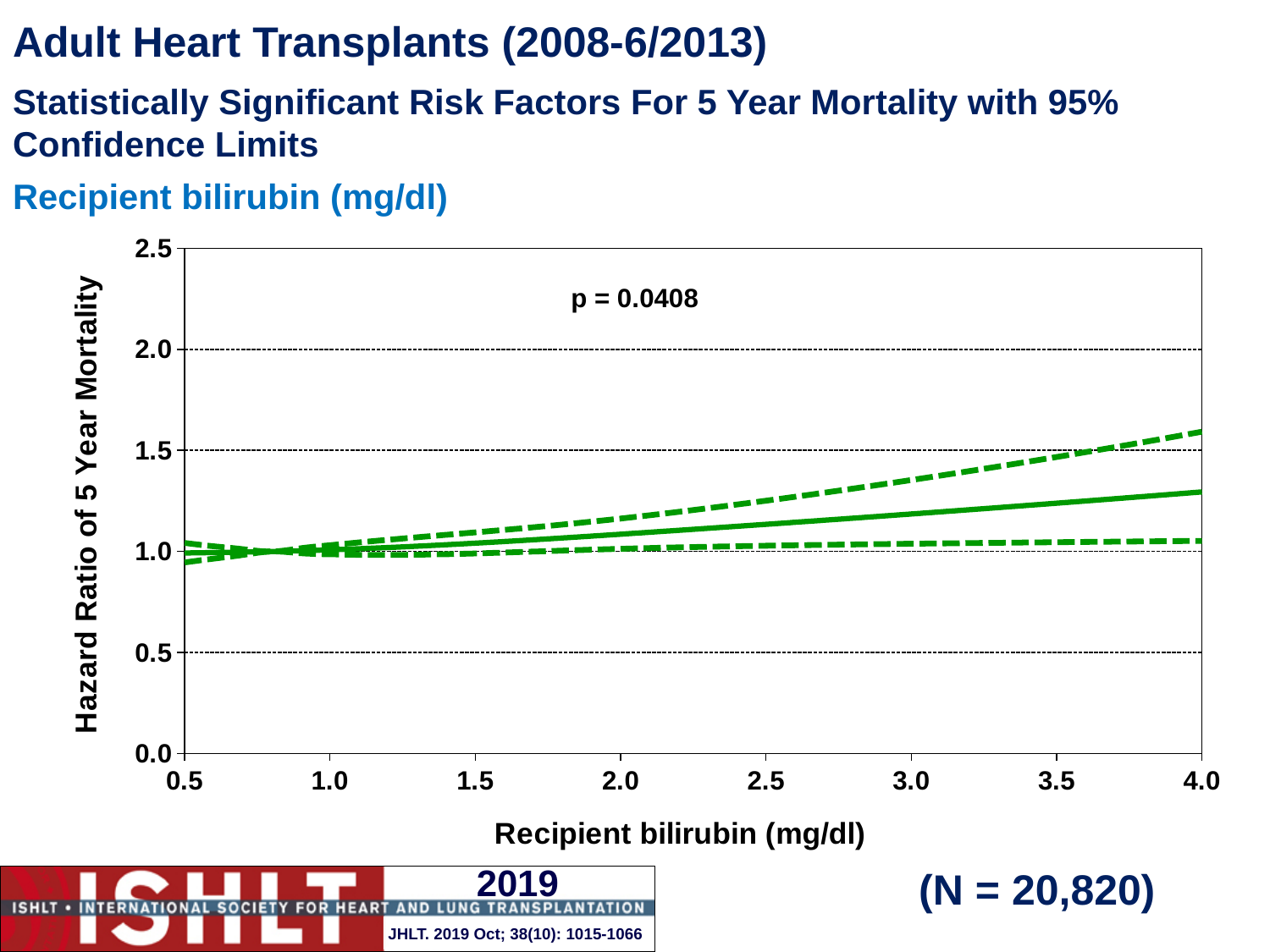
Is the upper dashed confidence limit at a recipient bilirubin of 2.0 mg/dl greater or less than 1.5? less Does the hazard ratio of 5 year mortality rise or fall as recipient bilirubin increases from 0.5 to 4.0 mg/dl? rise Is the lower dashed confidence limit at a recipient bilirubin of 4.0 mg/dl greater or less than 1.5? less What p-value is printed on the chart? p = 0.0408 Is the hazard ratio on the solid line at a recipient bilirubin of 4.0 mg/dl greater or less than 1.0? greater How many lines are plotted on the chart? 3 At a recipient bilirubin of 4.0 mg/dl, which is larger: the upper dashed line or the lower dashed line? the upper dashed line What is the N shown on the slide? N = 20,820 How many tick labels are shown on the x axis? 8 What kind of chart is shown on the slide? line chart